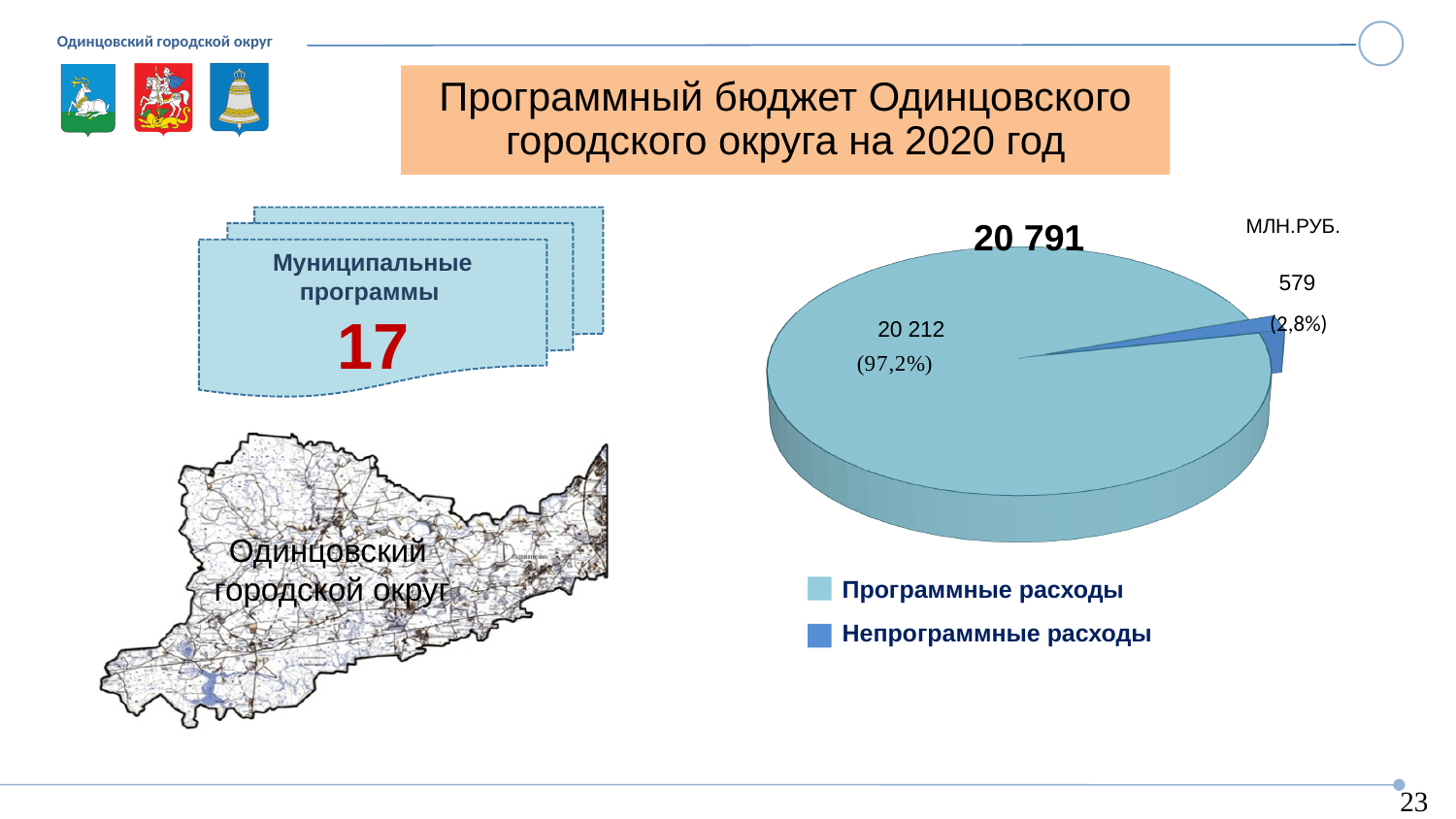
How many slices does the pie chart have? 2 What share of the pie does Программные расходы take? 97,2% How many entries does the legend of the pie chart list? 2 What total value is printed above the pie chart? 20 791 What kind of chart is shown on the slide? pie chart Which is larger, Программные расходы or Непрограммные расходы? Программные расходы What is the difference between the values for Программные расходы and Непрограммные расходы? 19 633 What is the value for Непрограммные расходы in the pie chart? 579 Which category has the largest slice in the pie chart? Программные расходы What is the value for Программные расходы in the pie chart? 20 212 Which category has the smallest slice in the pie chart? Непрограммные расходы What share of the pie does Непрограммные расходы take? 2,8%